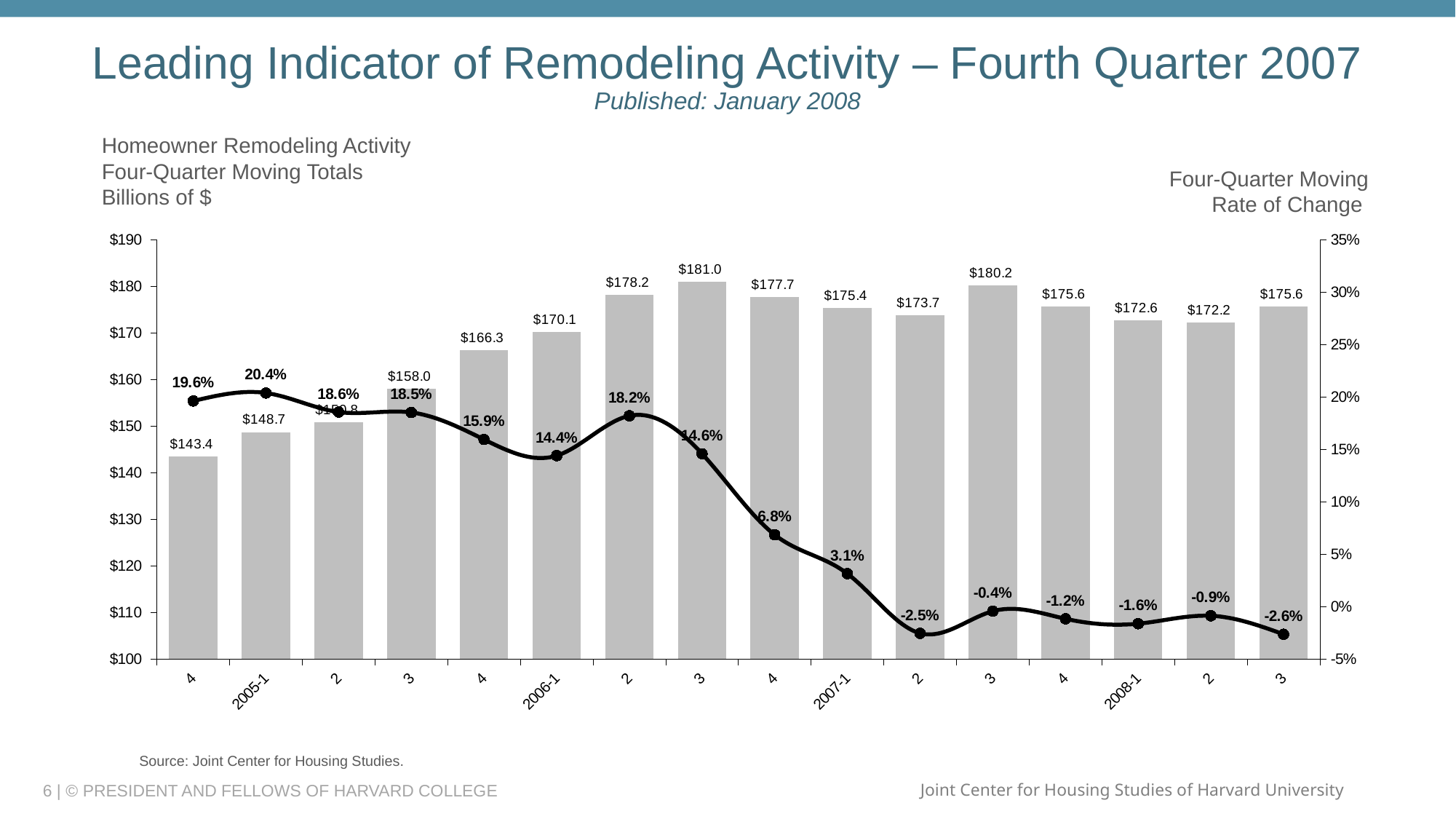
Which quarter has the highest four-quarter moving total of remodeling activity? The third quarter of 2006 (the '3' after 2006-1), at $181.0 What kind of chart is shown on the slide? A combination chart with bars and a line Which quarter has the lowest four-quarter moving rate of change? The last quarter, labeled 3 (after 2008-1), at -2.6% What is the difference between the four-quarter moving totals for 2007-1 and 2006-1? $5.3 Which is larger, the four-quarter moving total for 2005-1 or for 2006-1? 2006-1 What is the four-quarter moving total for 2008-1? $172.6 How many quarters are plotted along the x axis? 16 Which quarter has the highest four-quarter moving rate of change? 2005-1, at 20.4% What is the four-quarter moving total of homeowner remodeling activity for 2006-1? $170.1 Does the four-quarter moving rate of change line generally rise or fall from 2005-1 to the end of the chart? Fall Which quarter has the lowest four-quarter moving total of remodeling activity? The first bar, labeled 4 (before 2005-1), at $143.4 What is the four-quarter moving rate of change for 2007-1? 3.1%